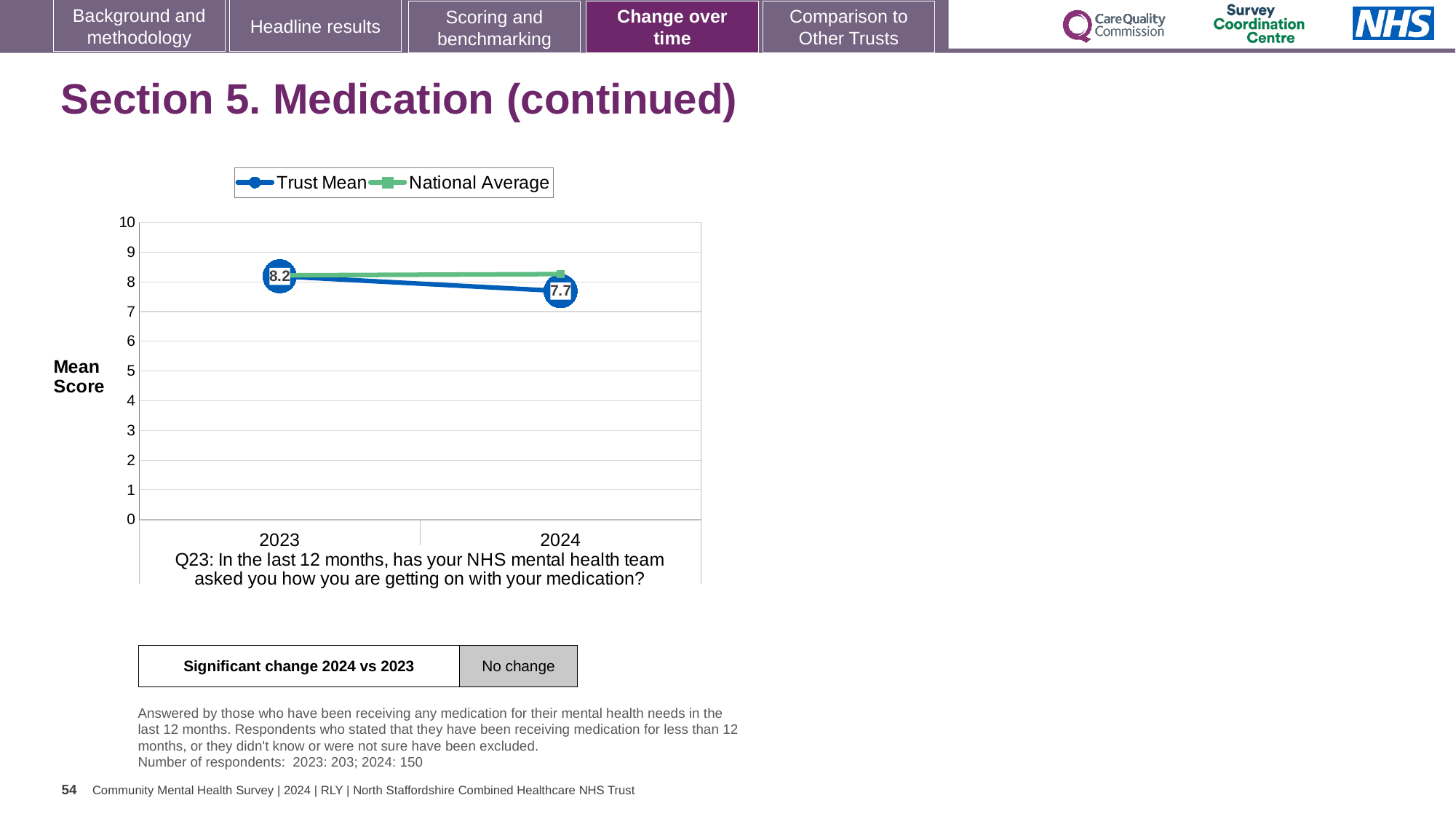
In 2024, which is higher: the Trust Mean or the National Average? National Average How many series does the legend list? 2 How many years are plotted on the x axis? 2 Does the Trust Mean rise or fall from 2023 to 2024? Fall In which year is the Trust Mean score higher? 2023 Is the Trust Mean value for 2024 greater or less than 8? less What is the Trust Mean score for 2023? 8.2 What kind of chart is shown on the slide? Line chart What is the Trust Mean score for 2024? 7.7 In which year is the Trust Mean score lower? 2024 What is the difference between the Trust Mean score in 2023 and in 2024? 0.5 Is the National Average value for 2024 greater or less than 8? greater